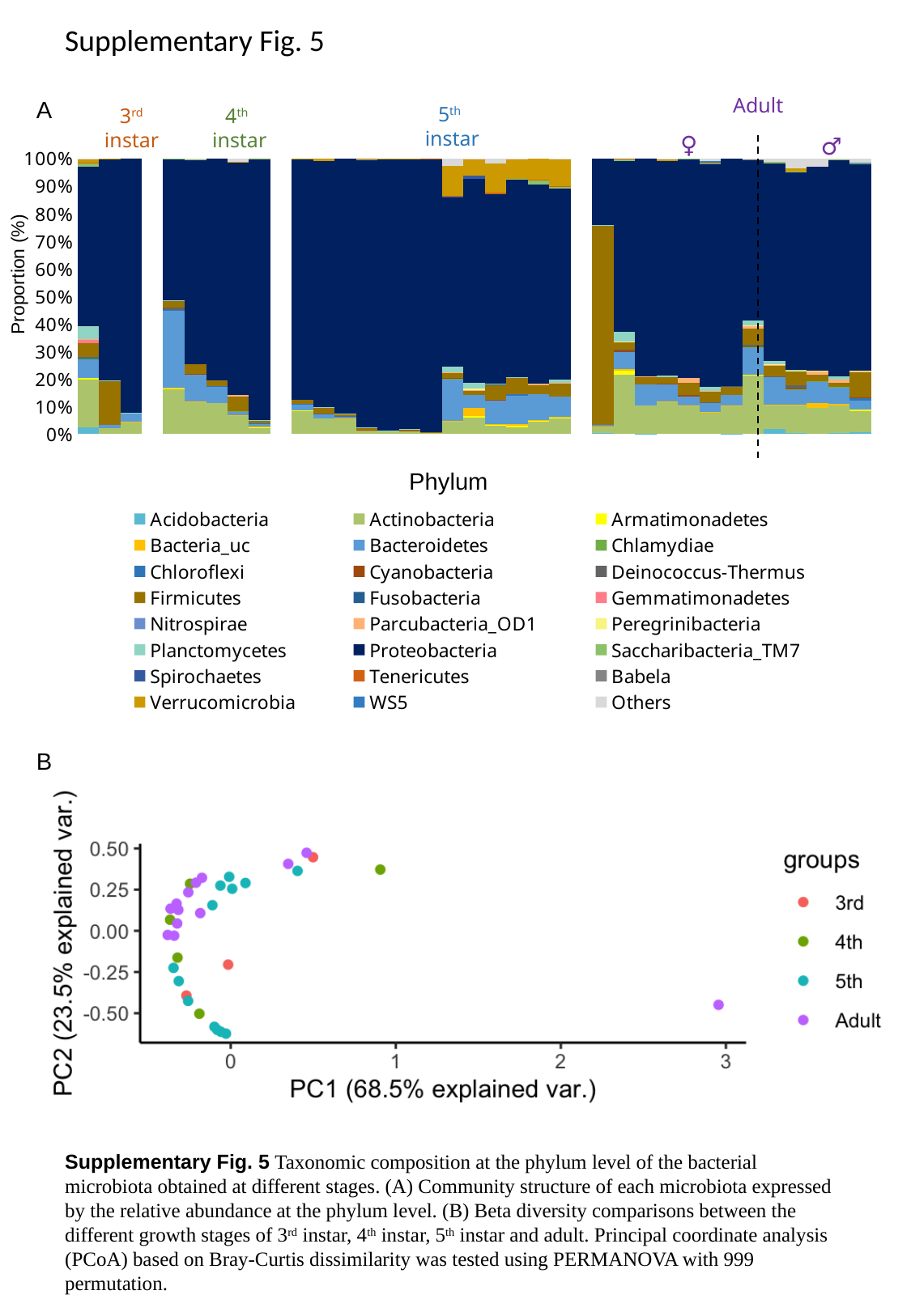
What kind of chart is panel B? Scatter plot In panel B, which group contains the point with the highest PC1 value? Adult In panel A, is the Proteobacteria proportion in the first bar of the 3rd instar group greater or less than 50%? greater In panel A, is the Firmicutes proportion in the first bar of the Adult group greater or less than 50%? greater In panel A, how many phylum entries does the legend list? 24 What kind of chart is panel A? Stacked bar chart In panel B, what percentage of variance is explained by PC2? 23.5% In panel A, what is the title of the legend? Phylum In panel B, how many groups does the legend list? 4 In panel A, how many developmental stage groups are shown along the x axis? 4 In panel B, is the PC1 value of the rightmost point greater or less than 2? greater In panel B, what percentage of variance is explained by PC1? 68.5%